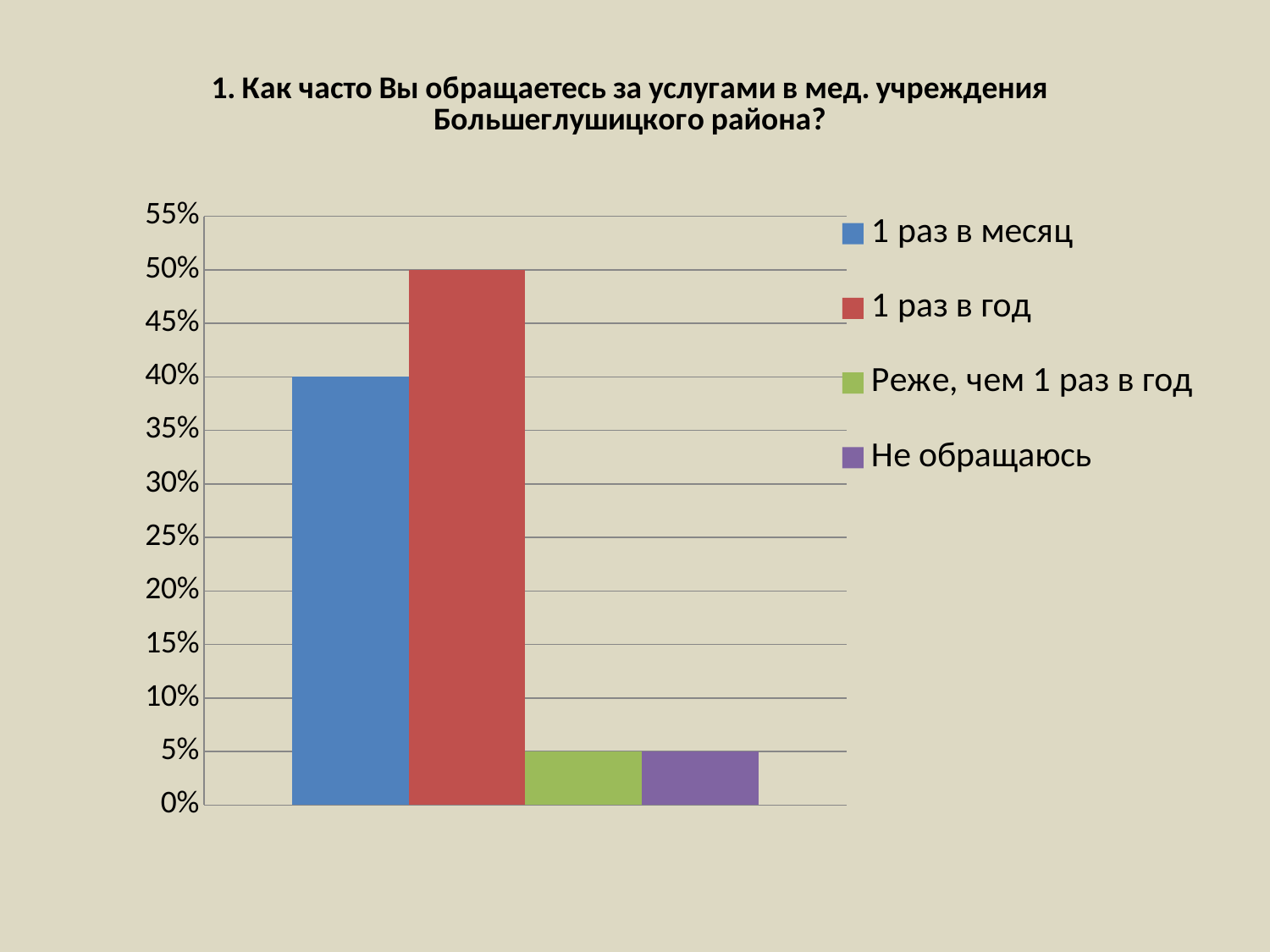
What type of chart is shown on the slide? bar chart What is the value for "1 раз в месяц"? 40% What is the value for "1 раз в год"? 50% What is the value for "Реже, чем 1 раз в год"? 5% Is the value for "1 раз в месяц" greater or less than 30%? greater How many series does the legend list? 4 What is the difference between the values for "1 раз в год" and "1 раз в месяц"? 10% What colour is the bar for "1 раз в год"? red What is the value for "Не обращаюсь"? 5% Which is larger, the value for "1 раз в месяц" or the value for "1 раз в год"? 1 раз в год Which answer option has the highest value? 1 раз в год How many bars are plotted on the chart? 4